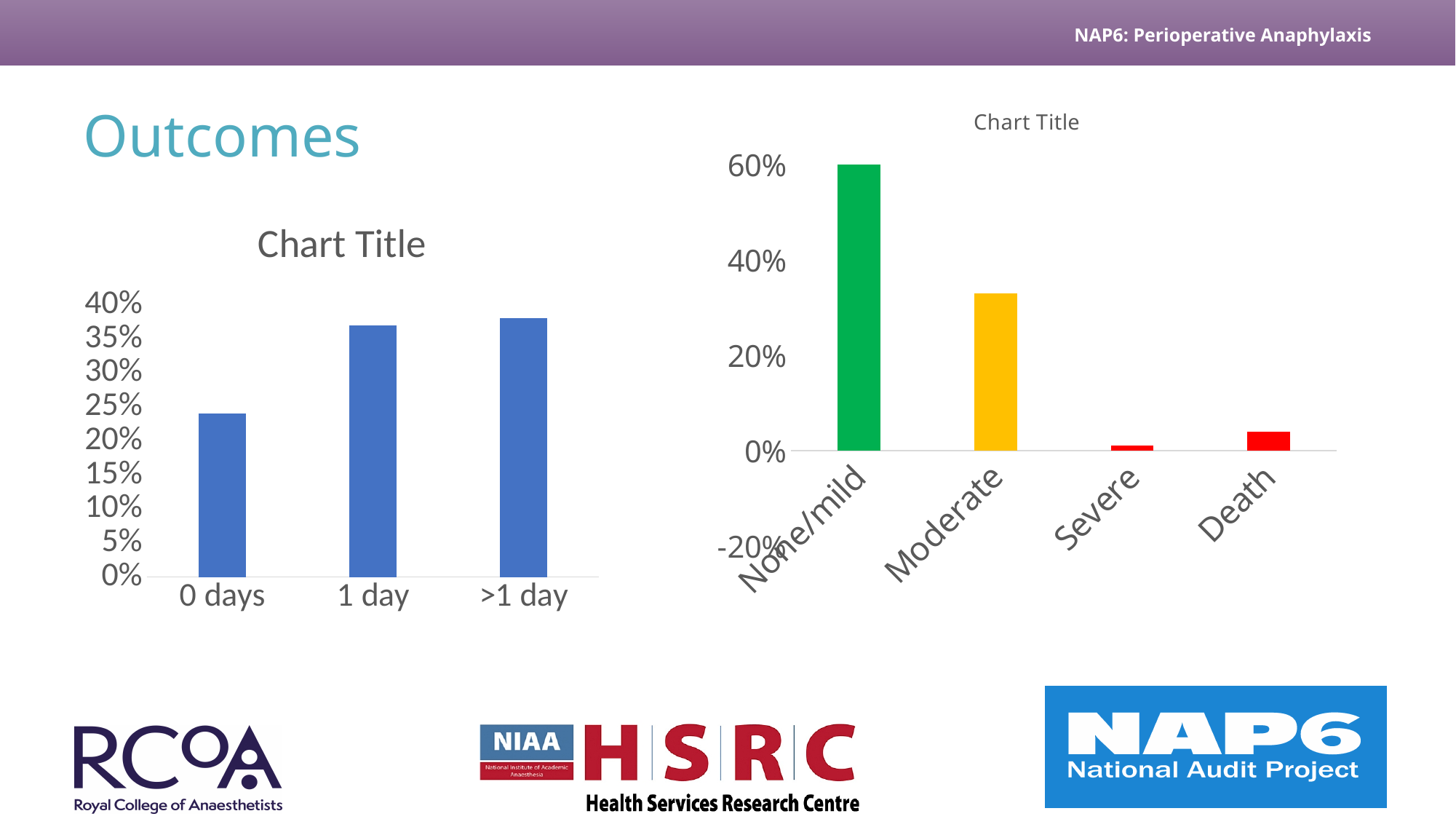
In the left chart, which category has the lowest value? 0 days In the left chart, do the values rise or fall from 0 days to >1 day? rise In the right chart, which category has the highest value? None/mild In the right chart, is the value for Moderate greater or less than 40%? less How many categories does the right chart show? 4 In the left chart, is the value for >1 day greater or less than 40%? less In the left chart, is the value for 0 days greater or less than 20%? greater What kind of chart is the left chart on the slide? bar chart In the right chart, which is larger, the value for Death or the value for Severe? Death In the right chart, which category has the lowest value? Severe How many categories does the left chart show? 3